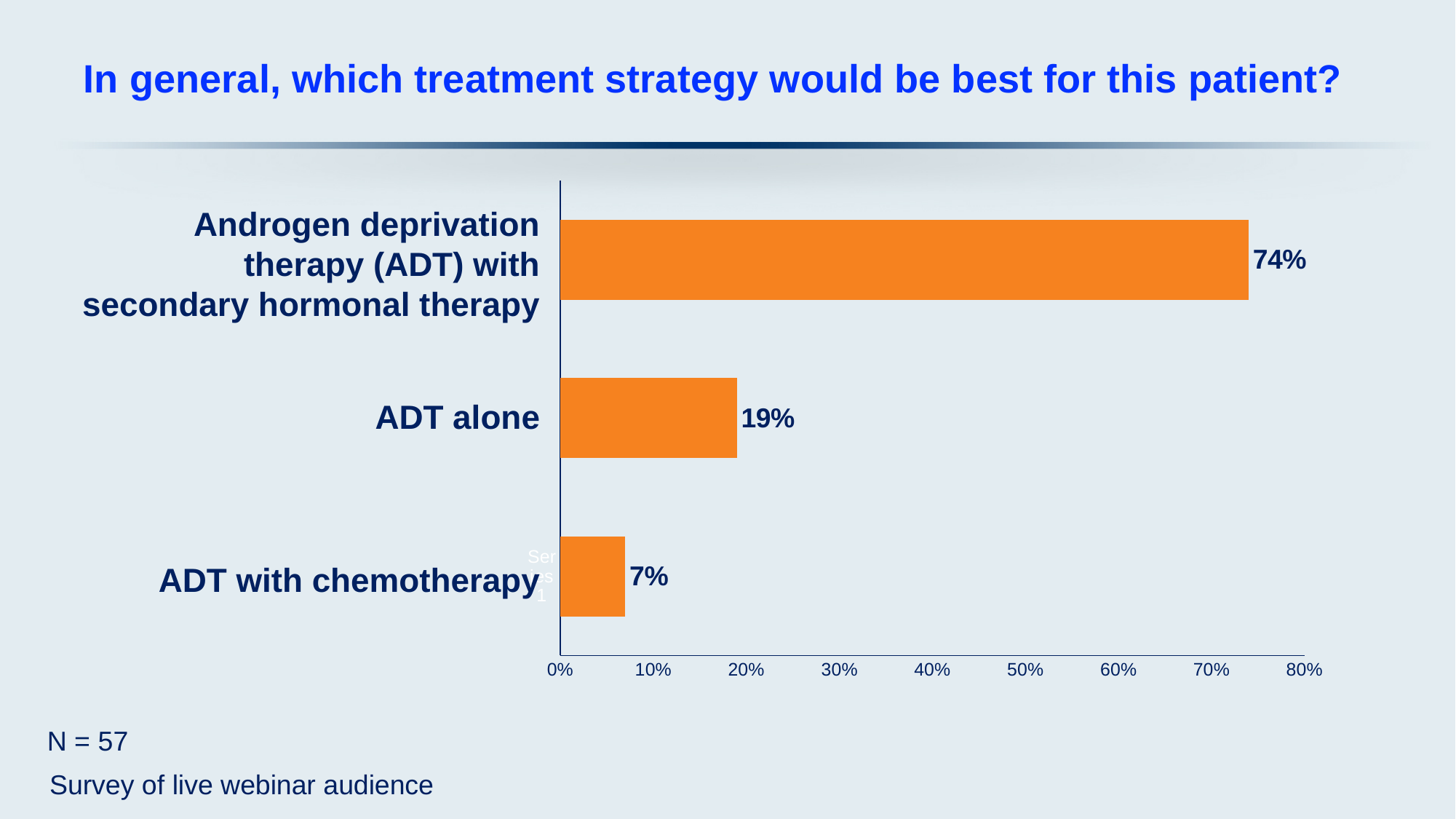
Which treatment strategy received the lowest share of responses? ADT with chemotherapy What percentage of respondents chose ADT alone? 19% What is the difference in percentage points between ADT alone and ADT with chemotherapy? 12 Is the value for ADT alone greater or less than 20%? less What is the sample size (N) stated on the slide? 57 Which treatment strategy received the highest share of responses? Androgen deprivation therapy (ADT) with secondary hormonal therapy How many treatment strategies are shown in the chart? 3 What is the difference in percentage points between ADT with secondary hormonal therapy and ADT alone? 55 What percentage of respondents chose Androgen deprivation therapy (ADT) with secondary hormonal therapy? 74% What type of chart is shown on the slide? Bar chart What percentage of respondents chose ADT with chemotherapy? 7% Which received more responses, ADT alone or ADT with chemotherapy? ADT alone